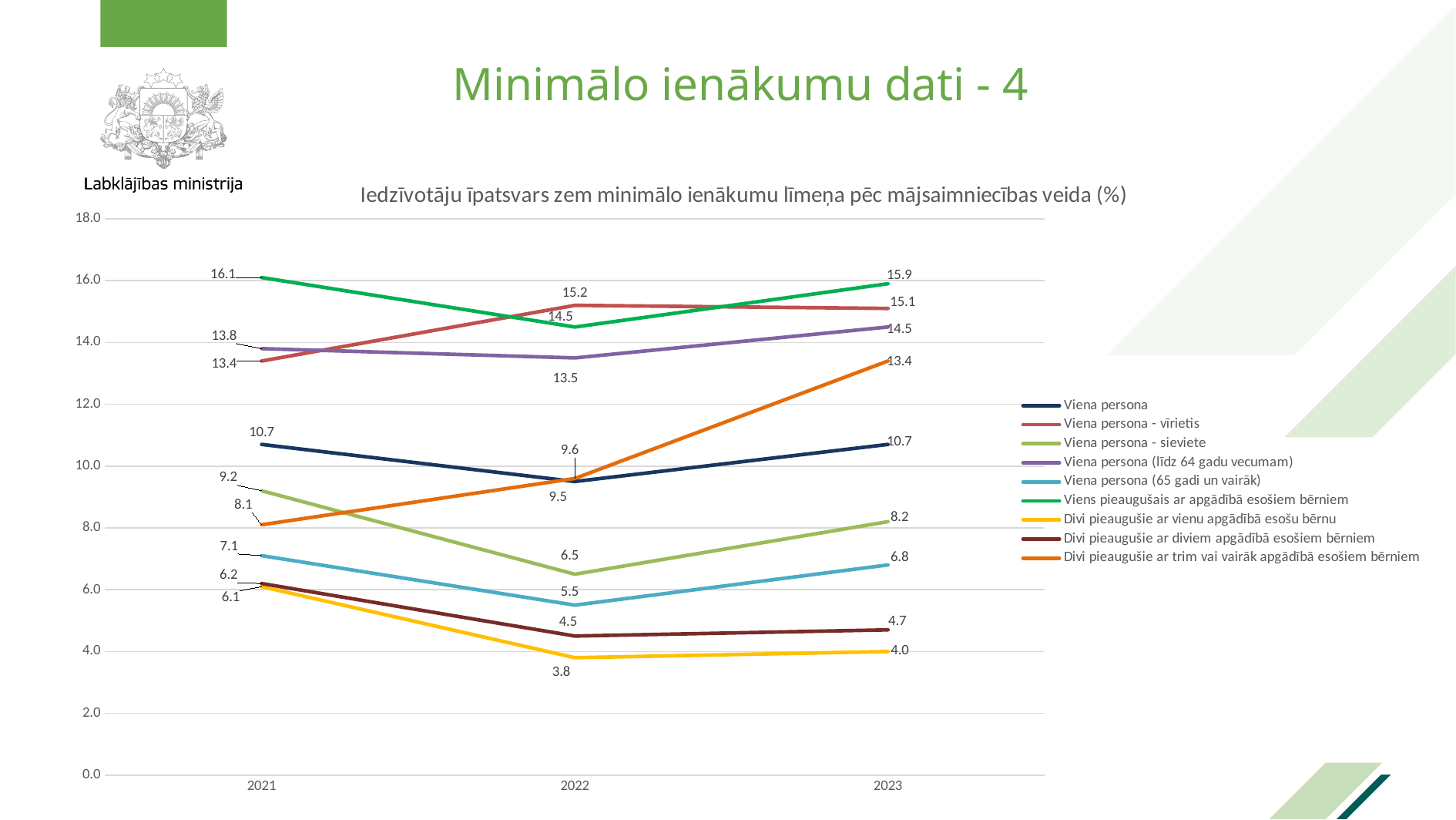
How many series does the legend list? 9 What is the value for 'Viens pieaugušais ar apgādībā esošiem bērniem' in 2021? 16.1 Which is larger in 2023: the value for 'Viena persona - vīrietis' or for 'Viena persona (līdz 64 gadu vecumam)'? Viena persona - vīrietis What is the value for 'Divi pieaugušie ar trim vai vairāk apgādībā esošiem bērniem' in 2023? 13.4 Does the value for 'Viena persona - sieviete' rise or fall from 2021 to 2022? fall Which series has the lowest value in 2023? Divi pieaugušie ar vienu apgādībā esošu bērnu What is the title of the chart? Iedzīvotāju īpatsvars zem minimālo ienākumu līmeņa pēc mājsaimniecības veida (%) How many years are shown on the x axis? 3 What is the difference between the 2023 and 2021 values for 'Divi pieaugušie ar trim vai vairāk apgādībā esošiem bērniem'? 5.3 Which series has the highest value in 2022? Viena persona - vīrietis What kind of chart is shown on the slide? line chart What is the value for 'Divi pieaugušie ar vienu apgādībā esošu bērnu' in 2022? 3.8